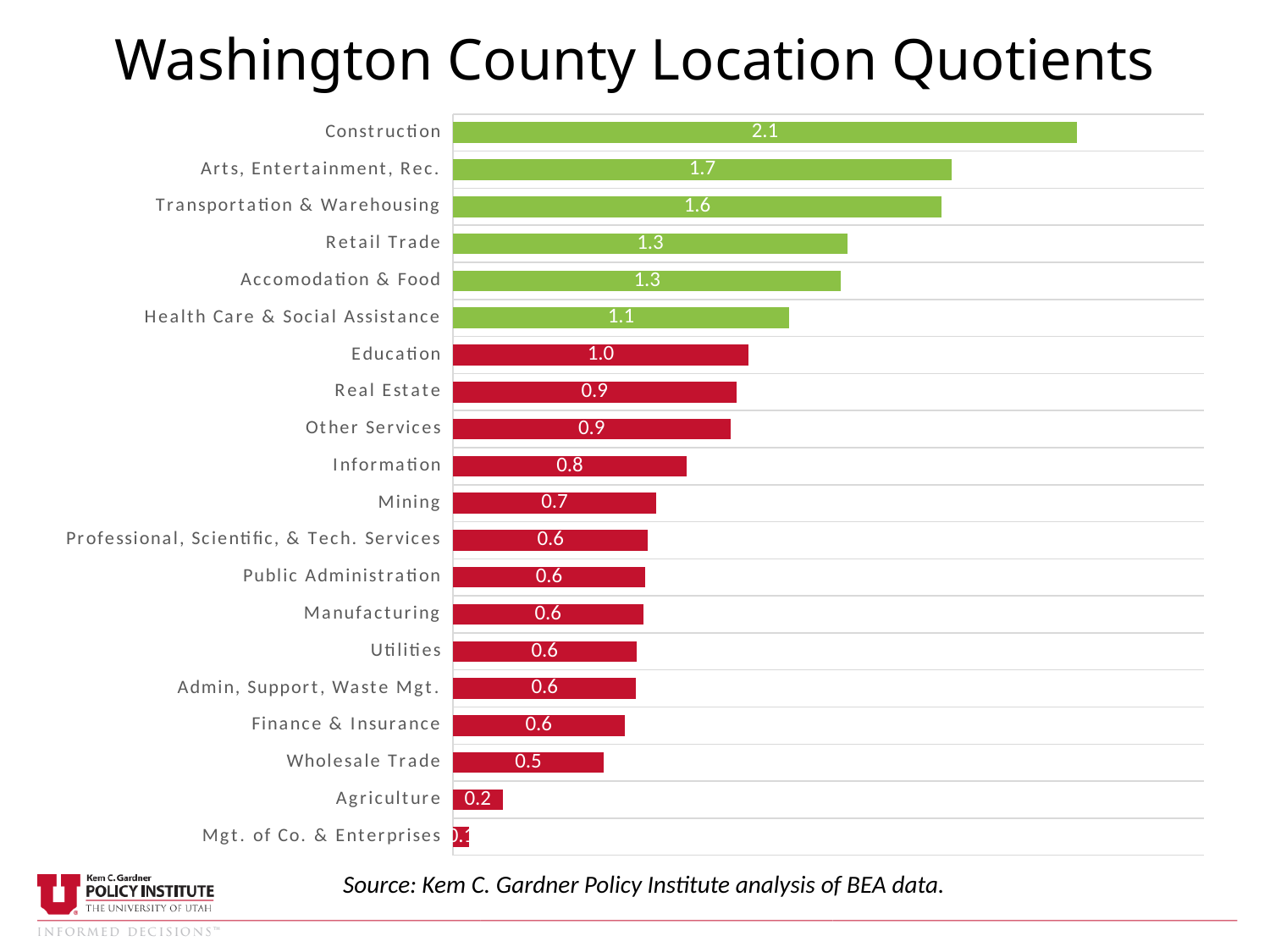
Which industry has the highest location quotient? Construction What colour are the bars for industries with a location quotient above 1.0? Green What type of chart is shown on the slide? Bar chart Which has a larger location quotient, Retail Trade or Information? Retail Trade What is the location quotient for Construction? 2.1 What is the location quotient for Education? 1.0 What is the difference between the location quotients for Construction and Arts, Entertainment, Rec.? 0.4 Which industry has the lowest location quotient? Mgt. of Co. & Enterprises What is the location quotient for Transportation & Warehousing? 1.6 What is the location quotient for Agriculture? 0.2 How many industries are shown in the chart? 20 What is the location quotient for Mining? 0.7